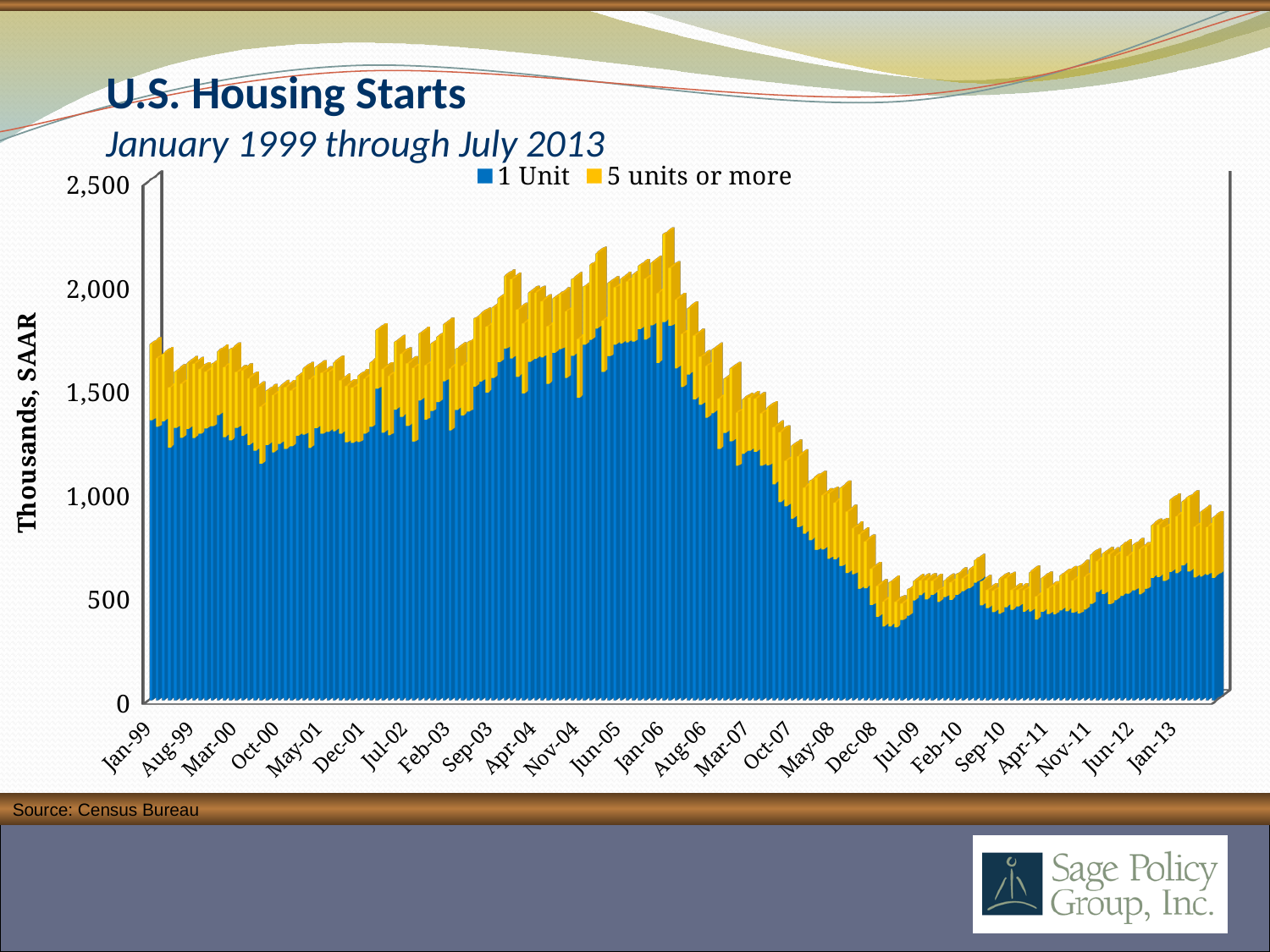
Do total housing starts rise or fall between Jan-06 and Dec-08? fall Around which x-axis label do total housing starts reach their highest level? Jan-06 How many series does the legend list? 2 Is the total stacked value for Jul-09 greater or less than 1,000? less Is the 1 Unit value for Jan-99 greater or less than 1,000? greater What are the two series named in the legend? 1 Unit and 5 units or more Is the total stacked value for Jan-06 greater or less than 2,000? greater What is the label on the vertical axis? Thousands, SAAR What kind of chart is shown on the slide? Stacked bar chart Which is larger, the total housing starts at Jan-06 or at Jan-13? Jan-06